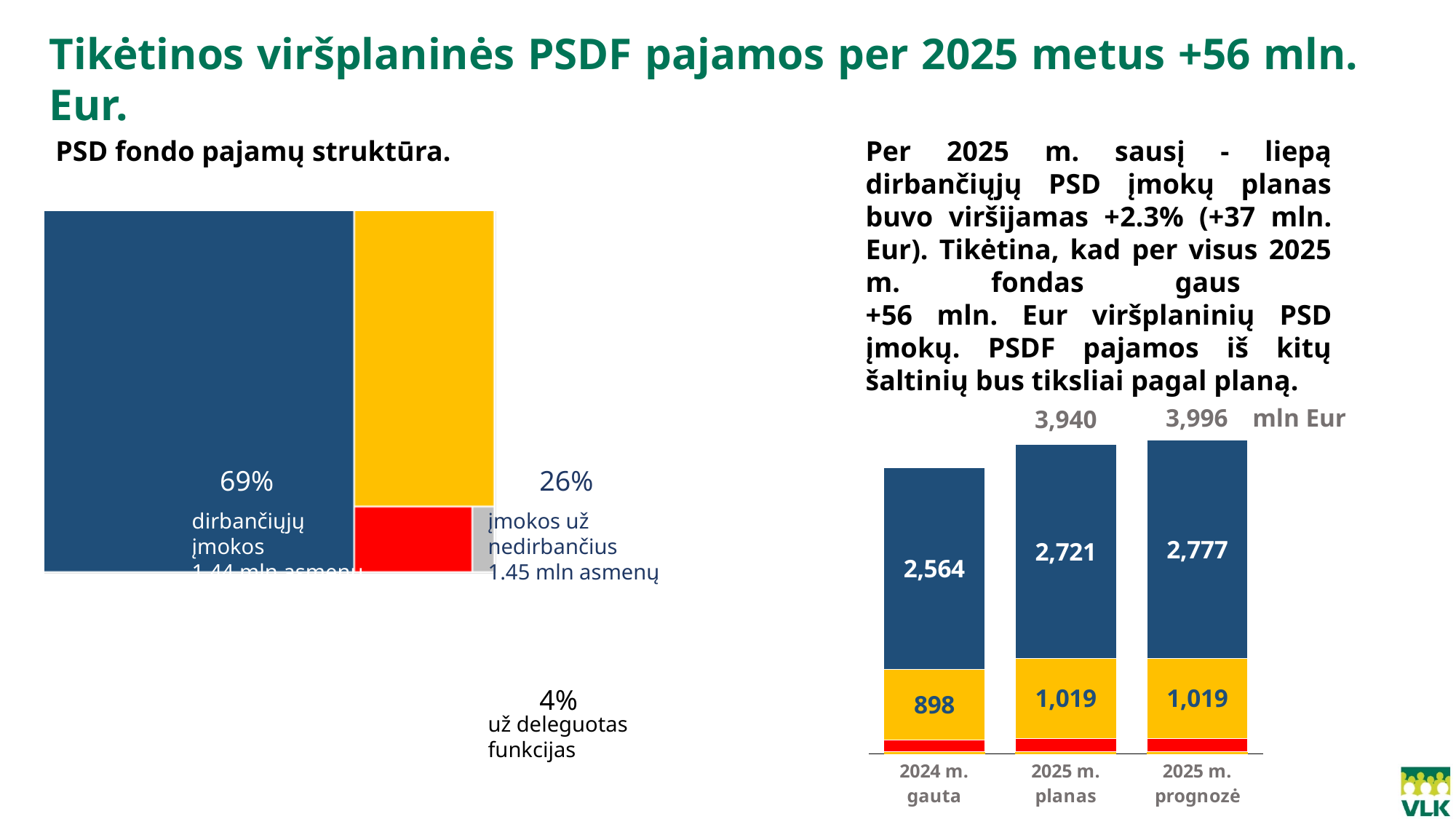
In the stacked bar chart on the right, which category has the highest blue segment value? 2025 m. prognozė In the stacked bar chart on the right, do the blue segment values rise or fall from 2024 m. gauta to 2025 m. prognozė? rise What kind of chart is the chart on the right of the slide? stacked bar chart In the stacked bar chart on the right, what is the total shown above the 2025 m. planas bar? 3,940 In the stacked bar chart on the right, which is larger: the yellow segment for 2024 m. gauta or for 2025 m. planas? 2025 m. planas In the stacked bar chart on the right, what is the total shown above the 2025 m. prognozė bar? 3,996 In the stacked bar chart on the right, what is the value of the blue segment for 2025 m. planas? 2,721 In the chart titled 'PSD fondo pajamų struktūra.', what share is labelled for už deleguotas funkcijas? 4% How many categories are shown on the x axis of the stacked bar chart on the right? 3 In the stacked bar chart on the right, what is the difference between the blue segment values for 2025 m. prognozė and 2025 m. planas? 56 In the stacked bar chart on the right, what is the value of the yellow segment for 2024 m. gauta? 898 In the chart titled 'PSD fondo pajamų struktūra.', what share is labelled for dirbančiųjų įmokos? 69%